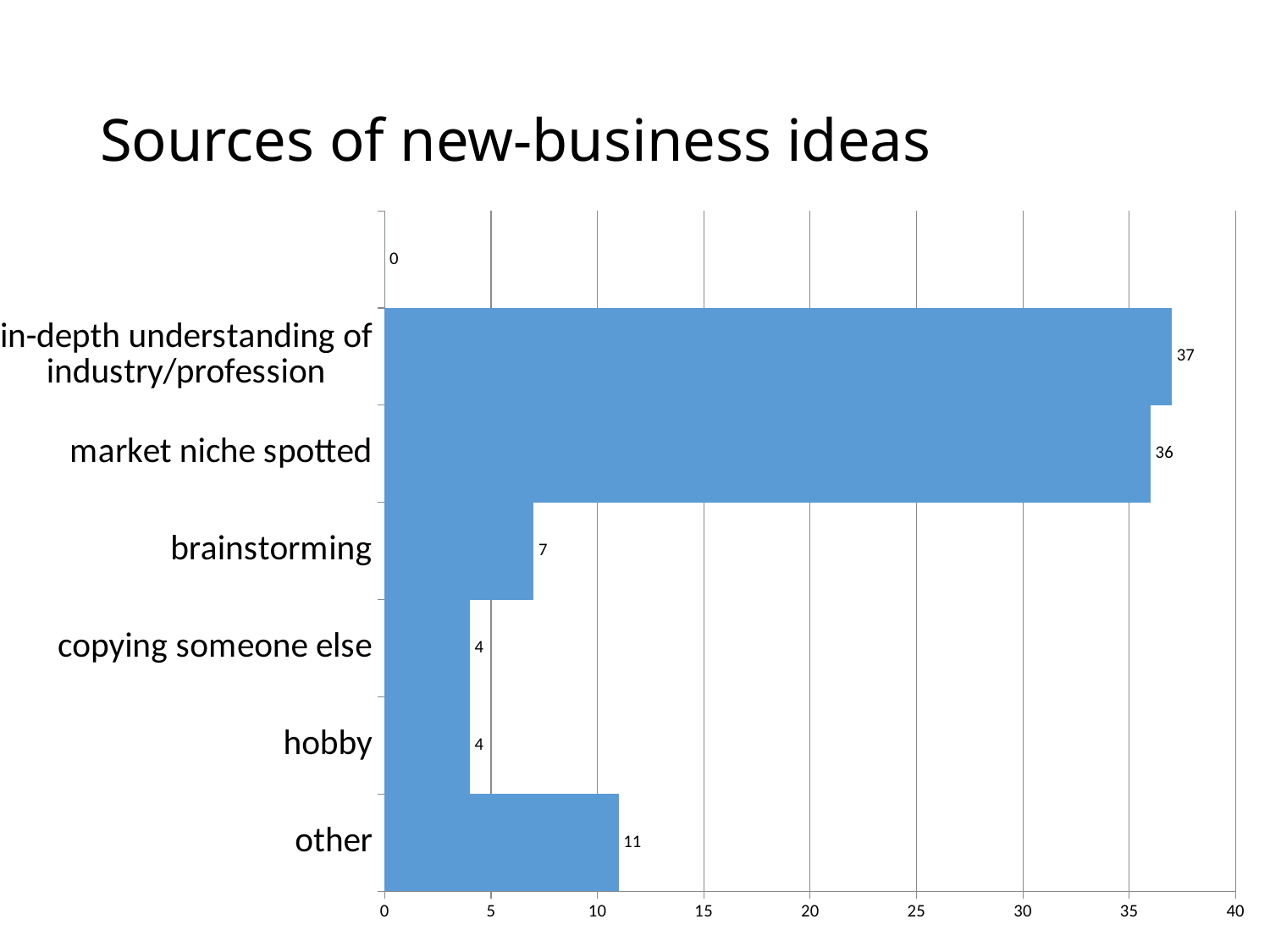
What is the value for market niche spotted? 36 Is the value for market niche spotted greater or less than 30? greater What is the difference between the values for in-depth understanding of industry/profession and market niche spotted? 1 What is the value for hobby? 4 What kind of chart is shown on the slide? bar chart Which is larger, the value for brainstorming or the value for other? other What is the difference between the values for other and brainstorming? 4 Which category has the highest value? in-depth understanding of industry/profession What is the value for other? 11 What is the value for copying someone else? 4 What is the value for brainstorming? 7 What is the value for in-depth understanding of industry/profession? 37